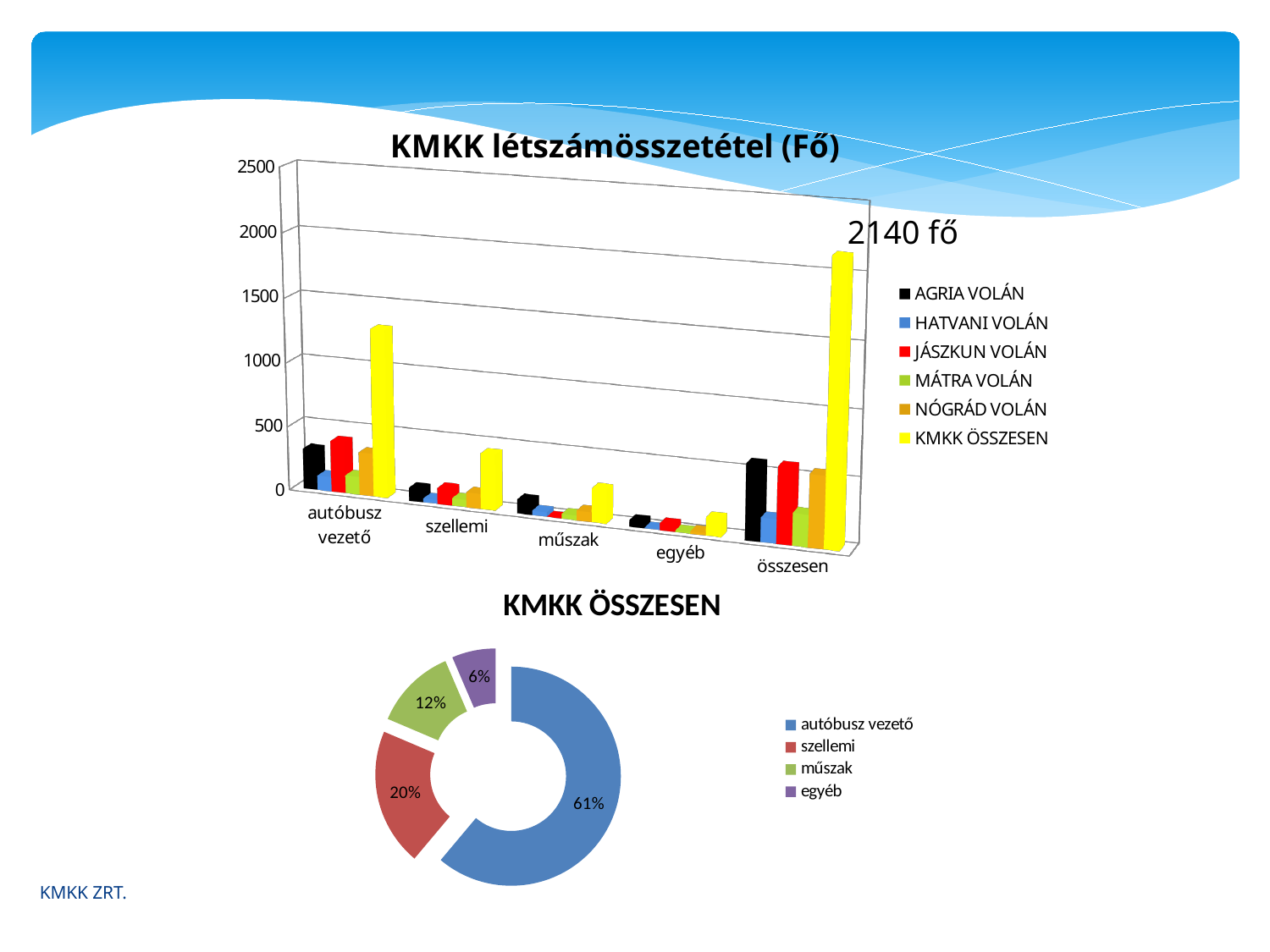
In the top bar chart, is the KMKK ÖSSZESEN value for 'autóbusz vezető' greater or less than 1000? greater What kind of chart is the top chart titled 'KMKK létszámösszetétel (Fő)'? bar chart In the bottom doughnut chart 'KMKK ÖSSZESEN', which category has the smallest share? egyéb In the bottom doughnut chart 'KMKK ÖSSZESEN', what share does 'autóbusz vezető' have? 61% What kind of chart is the bottom chart titled 'KMKK ÖSSZESEN'? doughnut chart In the top bar chart, how many series does the legend list? 6 In the top bar chart, is the KMKK ÖSSZESEN value for 'összesen' greater or less than 1500? greater In the top bar chart, which series is shown in yellow? KMKK ÖSSZESEN In the bottom doughnut chart 'KMKK ÖSSZESEN', how many slices are there? 4 In the bottom doughnut chart 'KMKK ÖSSZESEN', what is the difference in percentage points between 'autóbusz vezető' and 'szellemi'? 41 percentage points In the top bar chart, how many categories are shown on the x axis? 5 In the top bar chart, for 'autóbusz vezető', which is larger: JÁSZKUN VOLÁN or HATVANI VOLÁN? JÁSZKUN VOLÁN